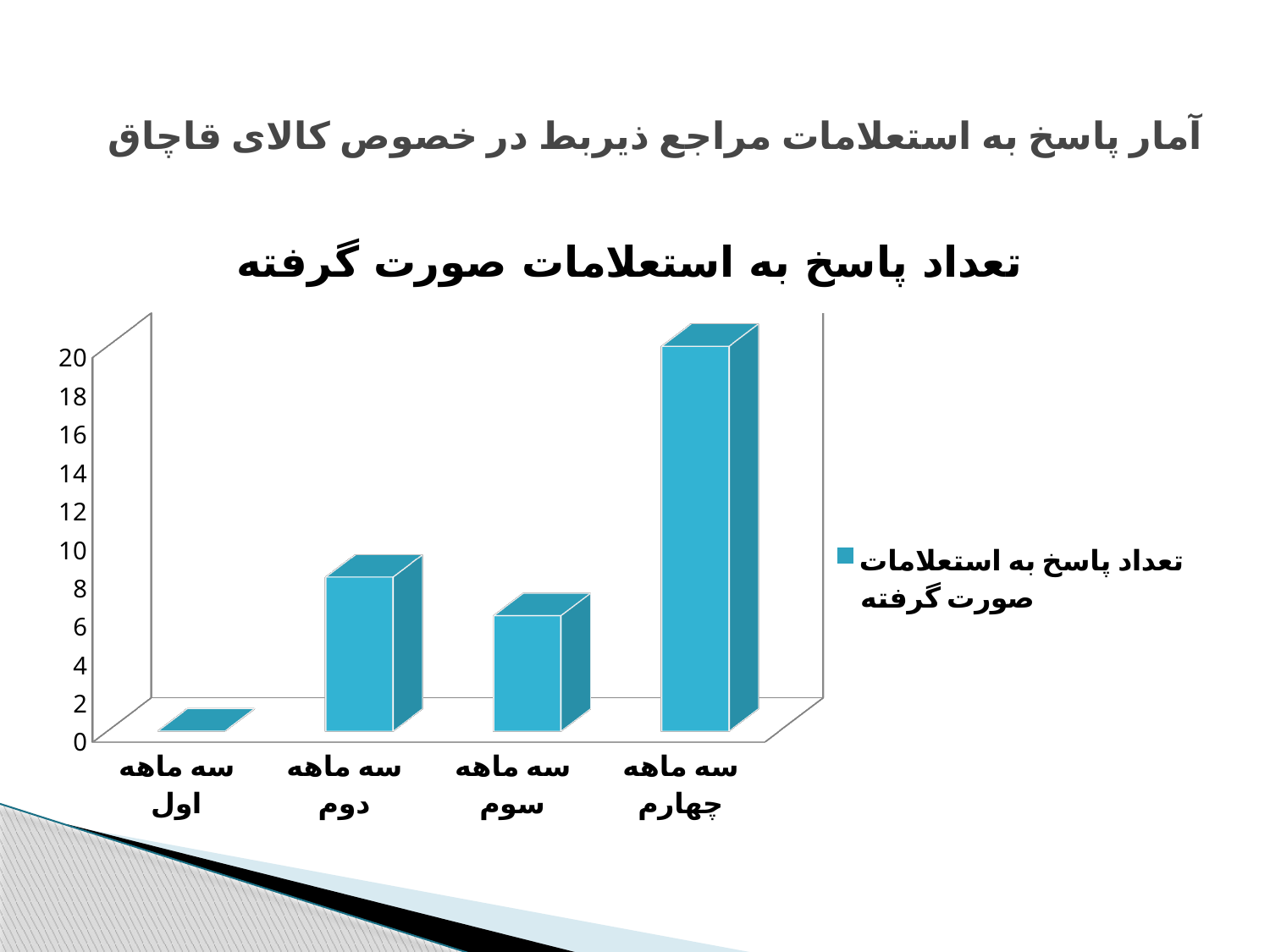
Is the value for سه ماهه اول greater or less than 2? less What is the legend entry of the chart? تعداد پاسخ به استعلامات صورت گرفته Which is larger, the value for سه ماهه دوم or the value for سه ماهه سوم? سه ماهه دوم Is the value for سه ماهه سوم greater or less than 4? greater How many series does the legend list? 1 Is the value for سه ماهه چهارم greater or less than 16? greater What kind of chart is shown on the slide? bar chart What is the title of the chart? تعداد پاسخ به استعلامات صورت گرفته How many categories are shown on the x axis of the chart? 4 Which category has the highest value? سه ماهه چهارم Which category has the lowest value? سه ماهه اول